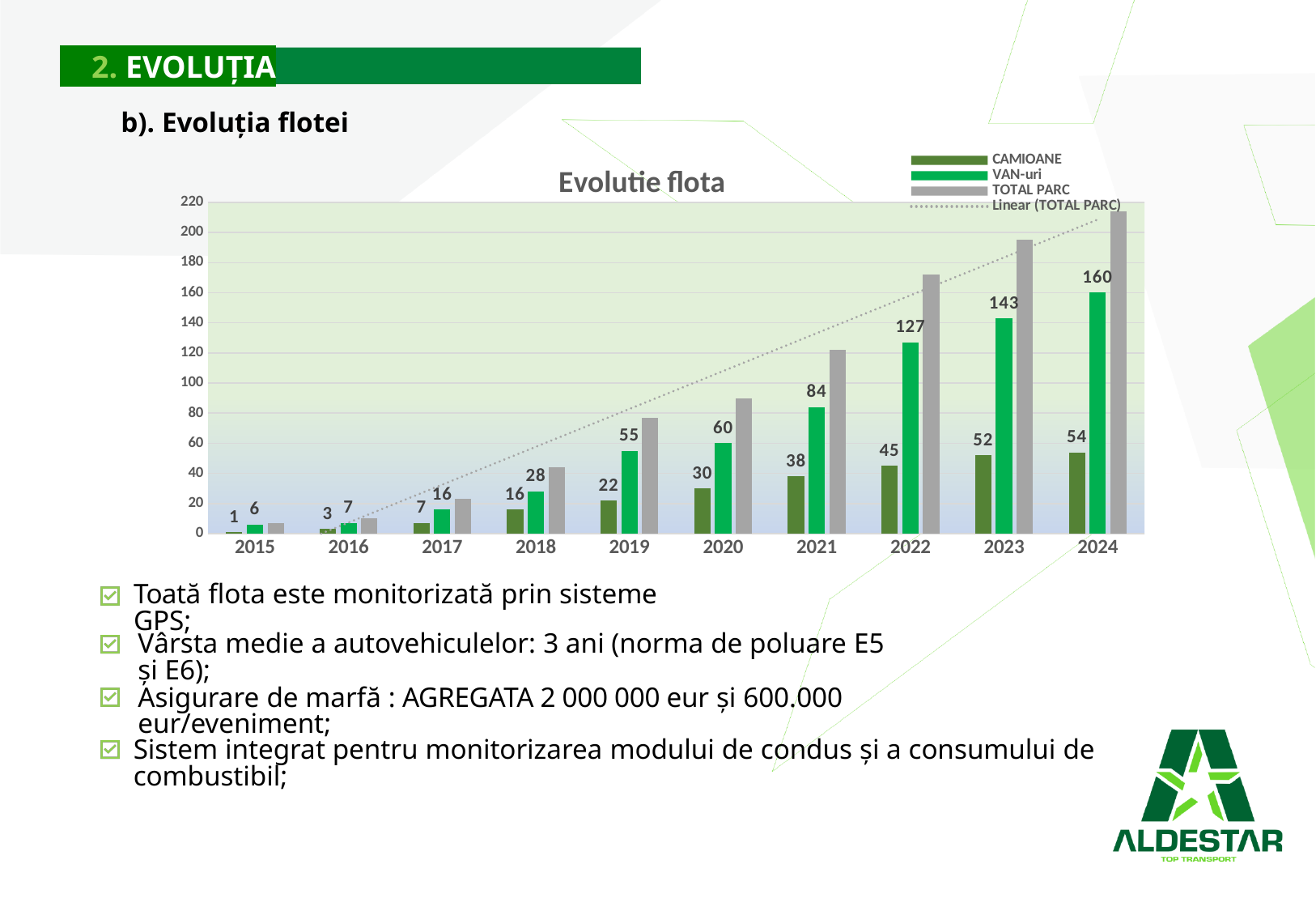
What is the value for CAMIOANE in 2019? 22 What type of chart is shown on the slide? bar chart Which is larger: the VAN-uri value in 2021 or the CAMIOANE value in 2024? VAN-uri in 2021 What is the title of the chart? Evolutie flota In which year is the CAMIOANE value highest? 2024 What is the value for VAN-uri in 2022? 127 What is the difference between the VAN-uri and CAMIOANE values in 2024? 106 How many years are shown on the x axis of the chart? 10 What is the value for VAN-uri in 2024? 160 Is the TOTAL PARC value for 2024 greater or less than 200? greater In which year is the VAN-uri value lowest? 2015 How many entries does the chart legend list? 4